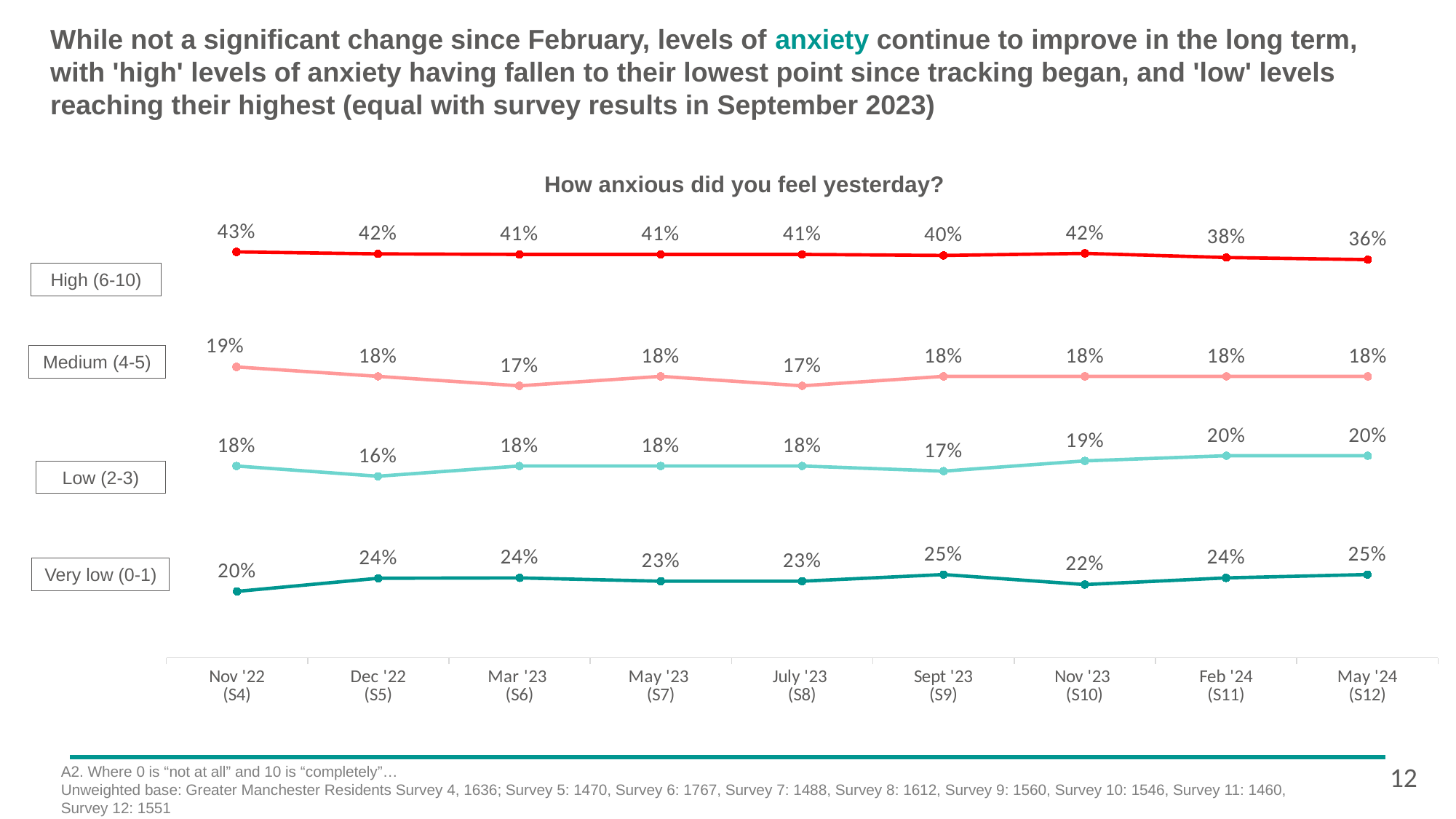
What is the value for Medium (4-5) in Nov '22 (S4)? 19% Which is larger in Sept '23 (S9): the Very low (0-1) value or the Low (2-3) value? Very low (0-1) How many survey time points are shown on the x axis? 9 What is the title of the chart? How anxious did you feel yesterday? At which survey point is the Low (2-3) value the lowest? Dec '22 (S5) What is the value for Low (2-3) in Dec '22 (S5)? 16% What is the value for Very low (0-1) in Nov '22 (S4)? 20% What is the difference between the High (6-10) value in Nov '22 (S4) and in May '24 (S12)? 7 percentage points How many series (anxiety levels) are plotted on the chart? 4 At which survey point is the High (6-10) value the highest? Nov '22 (S4) What is the value for High (6-10) in May '24 (S12)? 36% What type of chart is shown on the slide? line chart